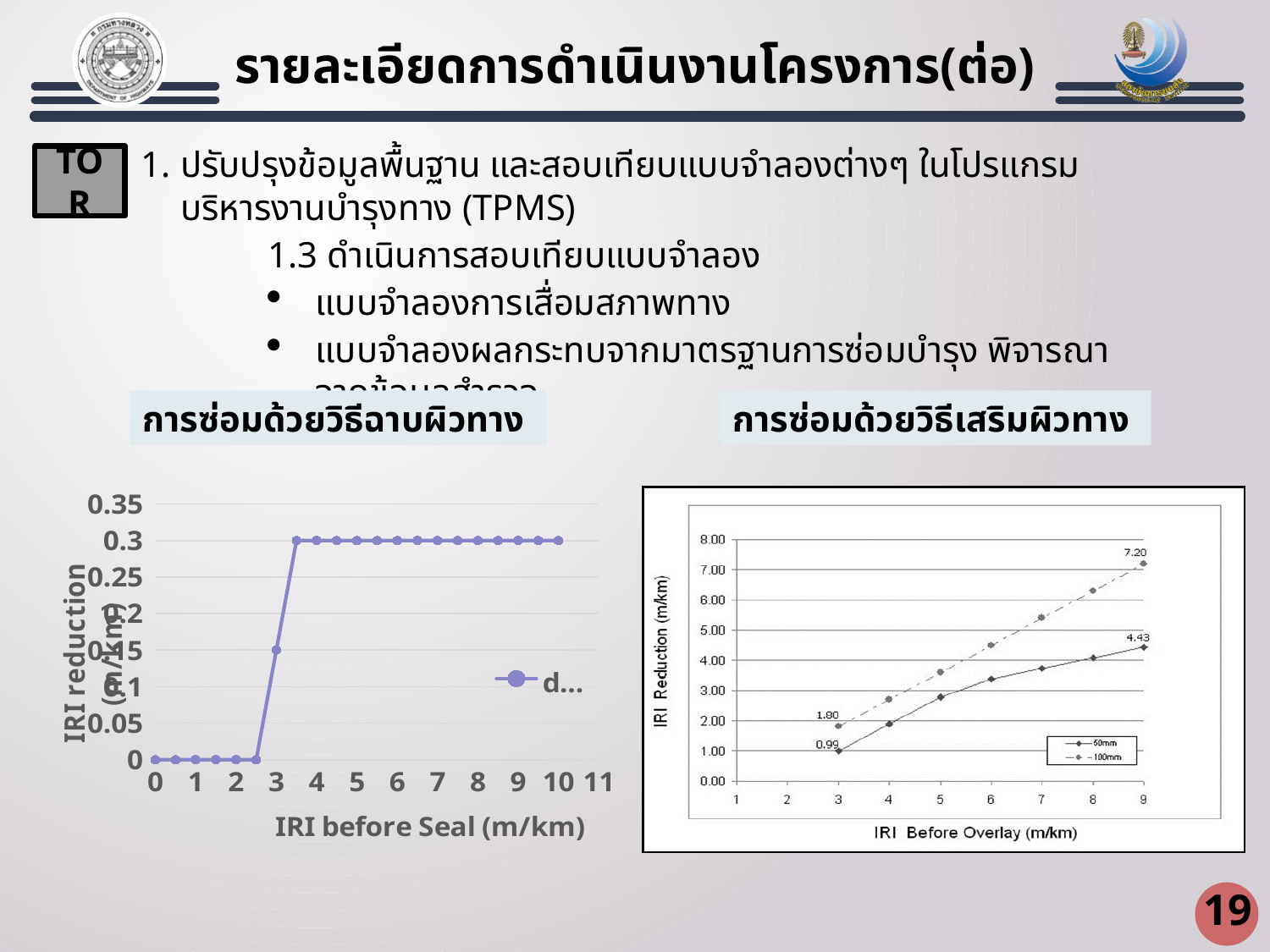
In the left chart, do the values rise or fall as IRI before Seal increases? rise In the left chart, what is the IRI reduction when IRI before Seal is 3 m/km? 0.15 How many series does the legend of the right chart list? 2 What kind of chart is the left chart (IRI before Seal)? line chart In the left chart, what is the IRI reduction when IRI before Seal is 5 m/km? 0.3 In the right chart, what is the IRI reduction for the 100mm series at IRI Before Overlay of 9 m/km? 7.20 In the right chart, which series has the larger IRI reduction at IRI Before Overlay of 3 m/km, 50mm or 100mm? 100mm What kind of chart is the right chart (IRI Before Overlay)? line chart In the right chart, what is the IRI reduction for the 50mm series at IRI Before Overlay of 3 m/km? 0.99 What is the x-axis title of the right chart? IRI Before Overlay (m/km) In the right chart, what is the difference between the 100mm and 50mm IRI reduction at IRI Before Overlay of 9 m/km? 2.77 In the left chart, what is the IRI reduction when IRI before Seal is 1 m/km? 0